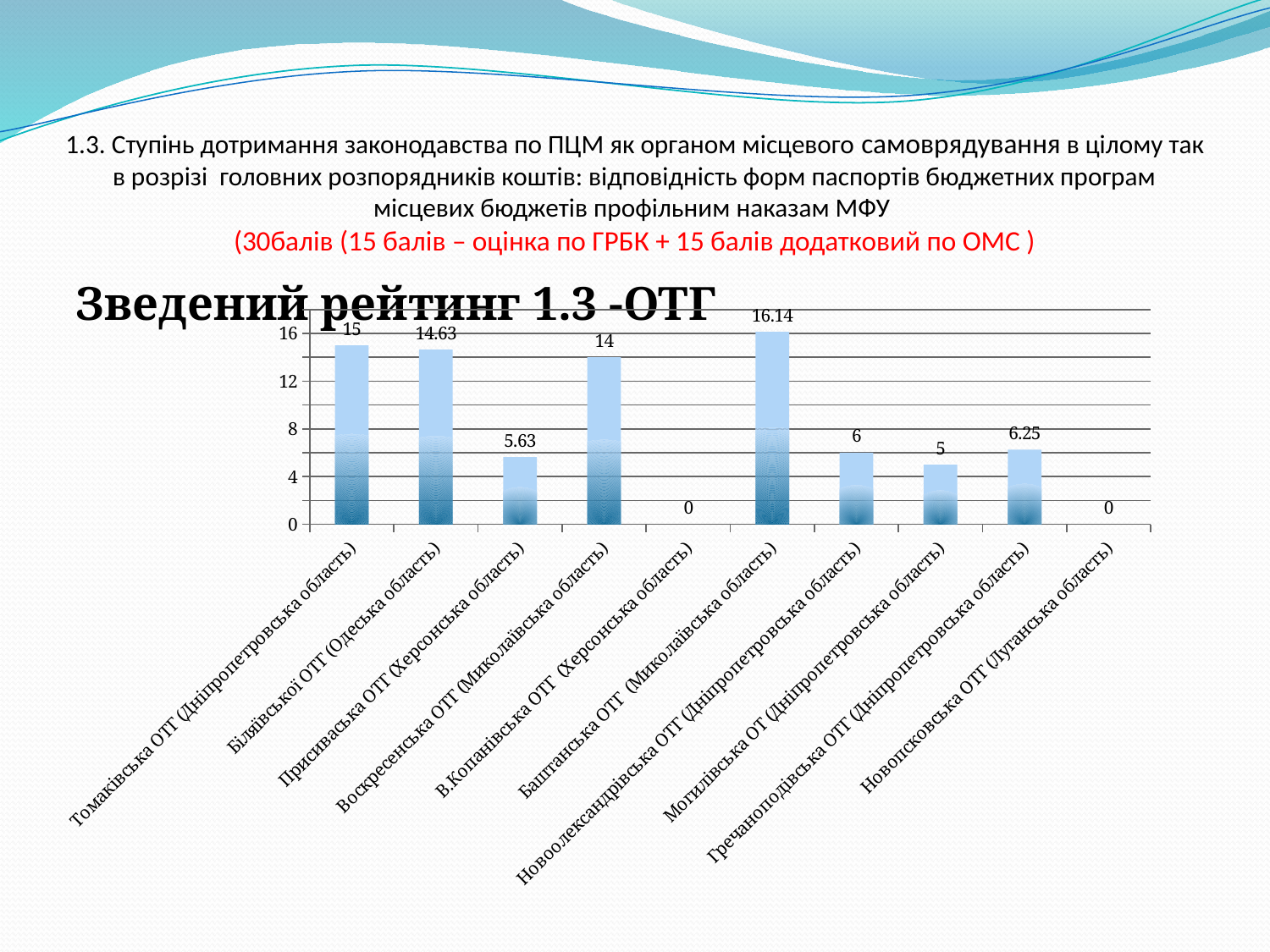
What is the difference between the values for Баштанська ОТГ (Миколаївська область) and Томаківська ОТГ (Дніпропетровська область)? 1.14 What is the title of the chart? Зведений рейтинг 1.3 -ОТГ What kind of chart is shown on the slide? Bar chart How many categories have a value of 0 in the chart? 2 Which is larger: the value for Новоолександрівська ОТГ (Дніпропетровська область) or the value for Мотилівська ОТ (Дніпропетровська область)? Новоолександрівська ОТГ (Дніпропетровська область) What value is shown for Томаківська ОТГ (Дніпропетровська область)? 15 What value is shown for Присиваська ОТГ (Херсонська область)? 5.63 What value is shown for Гречанопідівська ОТГ (Дніпропетровська область)? 6.25 How many categories are shown on the x axis of the chart? 10 What is the difference between the values for Біляївської ОТГ (Одеська область) and Воскресенська ОТГ (Миколаївська область)? 0.63 What value is shown for Баштанська ОТГ (Миколаївська область)? 16.14 Which category has the highest value in the chart? Баштанська ОТГ (Миколаївська область)